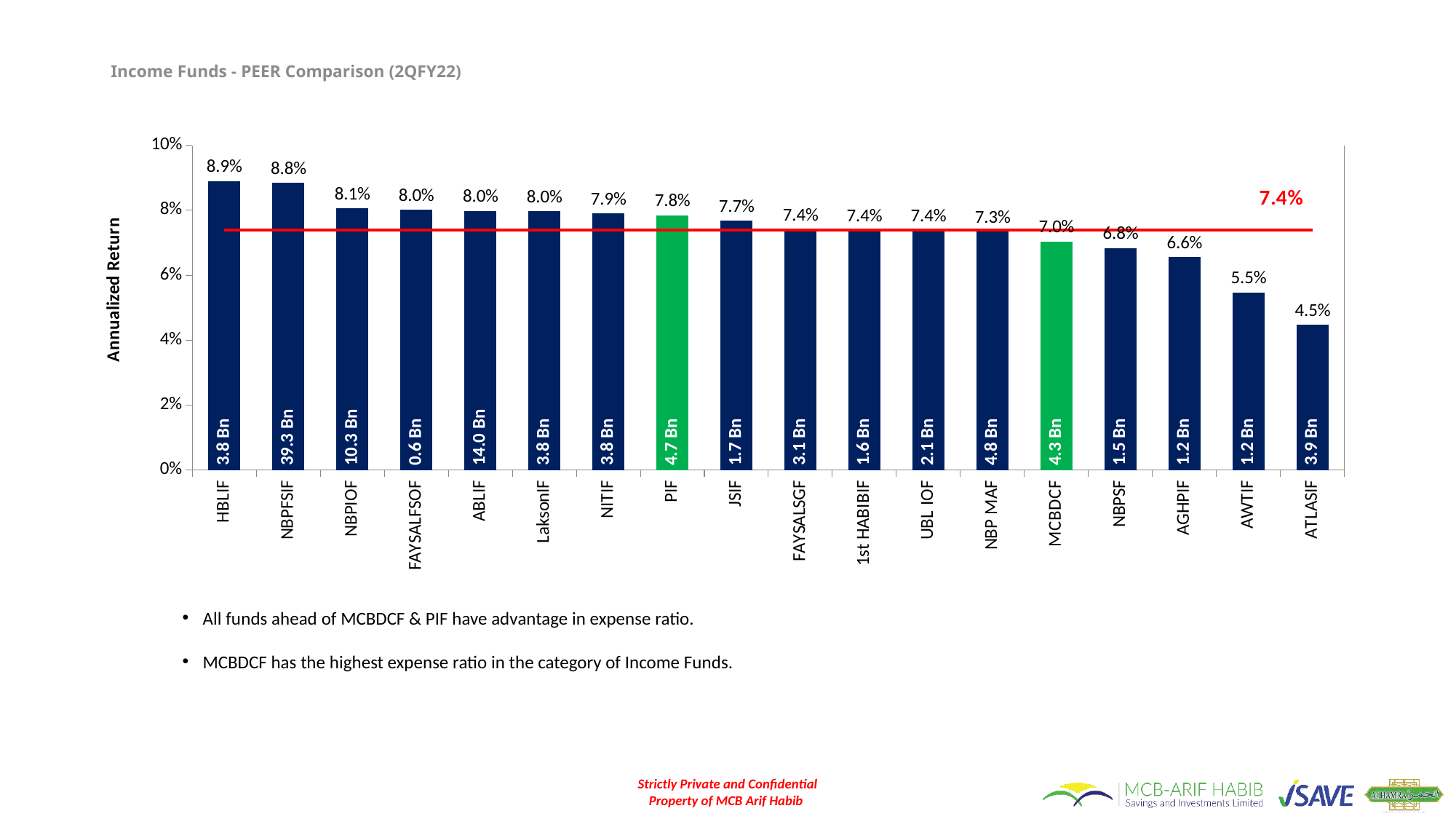
Is the annualized return for AGHPIF greater or less than 6%? greater What is the annualized return for MCBDCF? 7.0% Which has a higher annualized return, NBPSF or AWTIF? NBPSF What value does the red horizontal line in the chart mark? 7.4% Which fund has the highest annualized return? HBLIF How many funds are shown in the chart? 18 What type of chart is shown on the slide? Bar chart Which fund has the lowest annualized return? ATLASIF What is the difference in annualized return between HBLIF and ATLASIF? 4.4% What is the annualized return for PIF? 7.8% What is the difference in annualized return between PIF and MCBDCF? 0.8% What is the annualized return for HBLIF? 8.9%